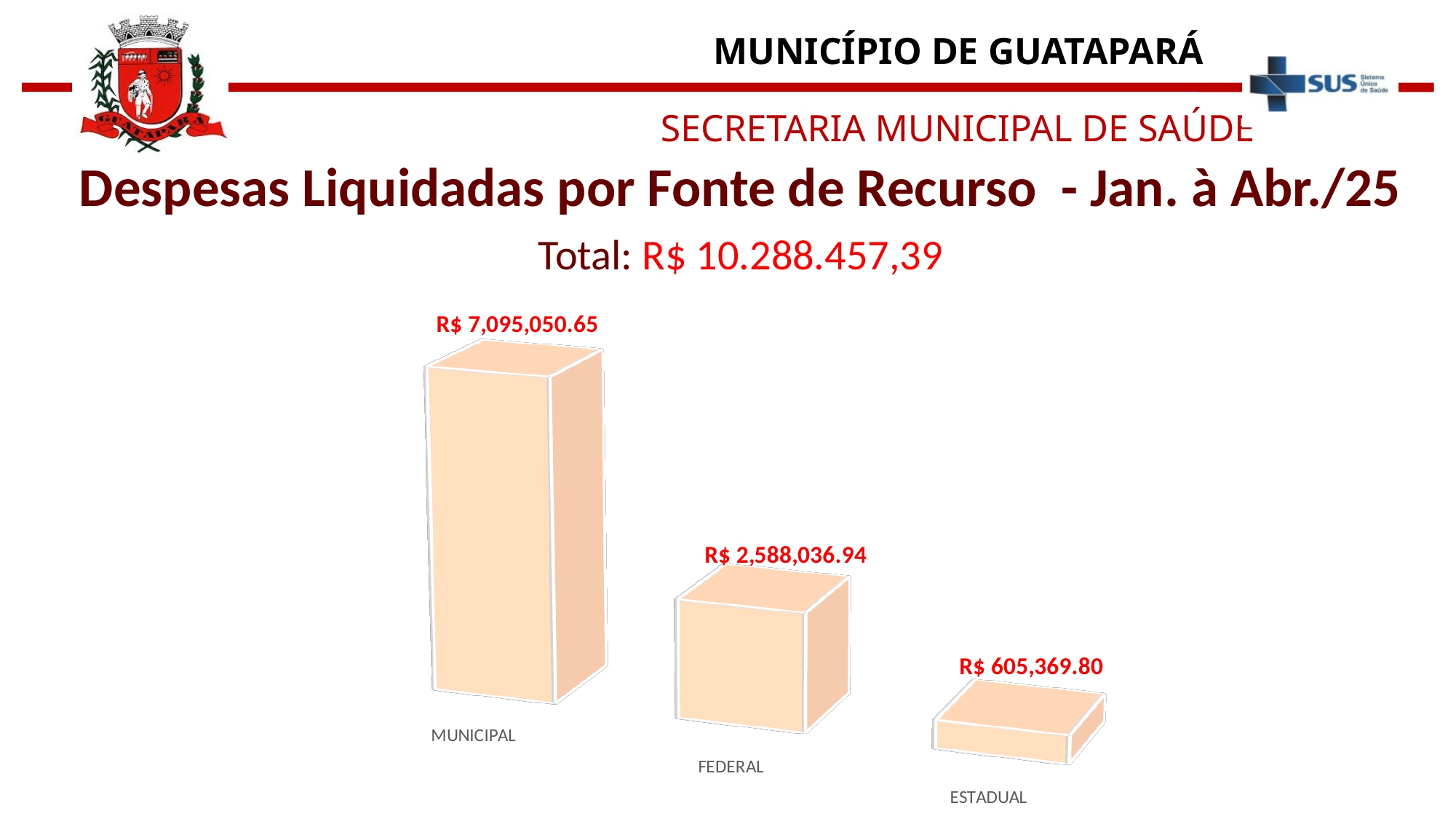
Which is larger, the value for FEDERAL or the value for ESTADUAL? FEDERAL Which category has the highest value? MUNICIPAL What is the value for ESTADUAL? R$ 605,369.80 What is the value for MUNICIPAL? R$ 7,095,050.65 What is the difference between the FEDERAL and ESTADUAL values? R$ 1,982,667.14 How many categories are shown in the chart? 3 Which category has the lowest value? ESTADUAL What is the difference between the MUNICIPAL and FEDERAL values? R$ 4,507,013.71 What total is stated on the slide above the chart? R$ 10.288.457,39 What kind of chart is shown on the slide? Bar chart Do the values rise or fall from left to right across the categories? Fall What is the value for FEDERAL? R$ 2,588,036.94